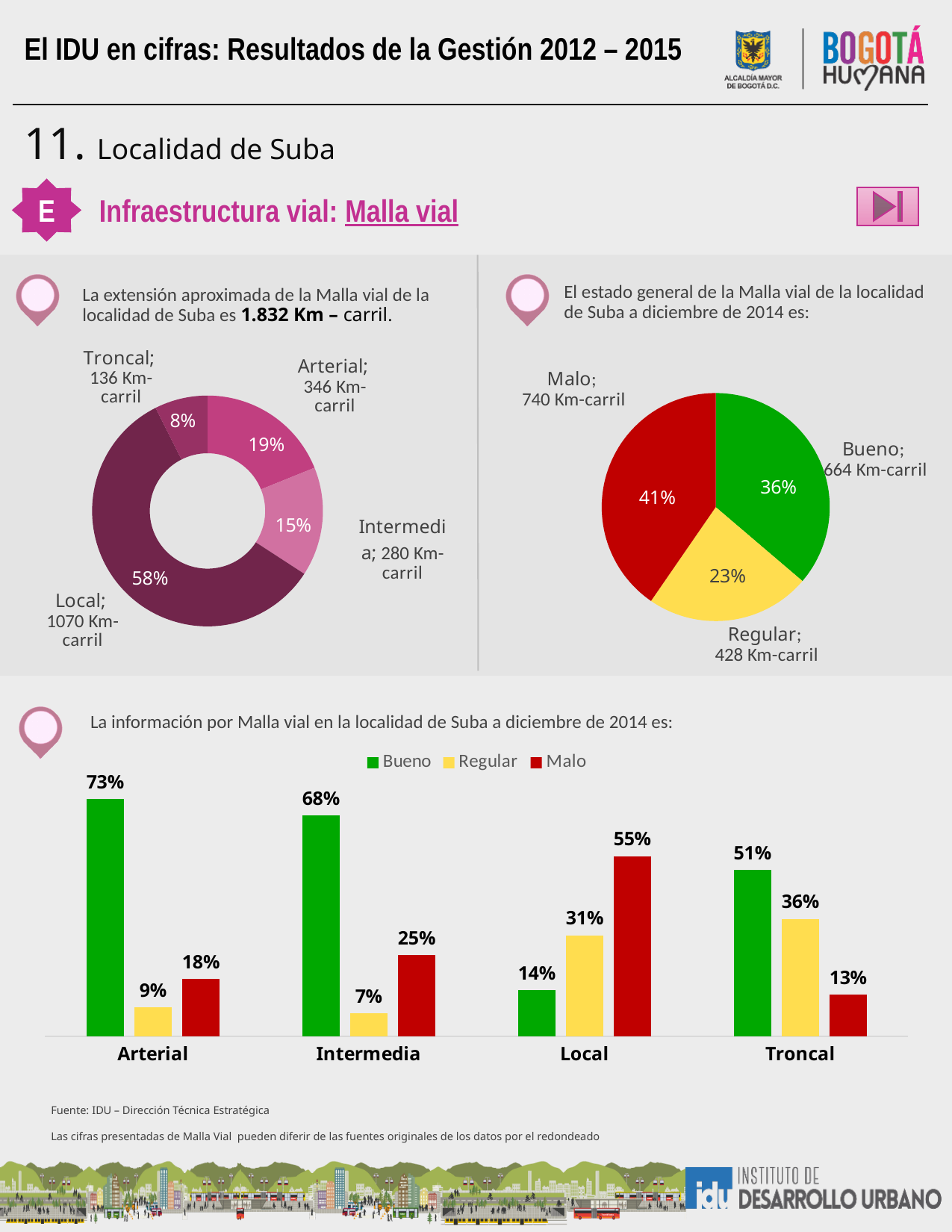
In the bottom bar chart, what is the difference between the Bueno values for Arterial and Troncal? 22% In the donut chart on the left, how many categories are shown? 4 In the pie chart on the right, what percentage share does Malo have? 41% In the donut chart on the left, what percentage share does Local have? 58% In the pie chart on the right, which state has the largest share? Malo In the bottom bar chart, what is the Malo value for Local? 55% In the donut chart on the left, which category has the smallest share? Troncal In the bottom bar chart, how many series does the legend list? 3 In the donut chart on the left, how many Km-carril does Arterial have? 346 Km-carril In the bottom bar chart, what is the Bueno value for Intermedia? 68% What kind of chart is the bottom chart? Bar chart In the pie chart on the right, how many Km-carril are in Regular state? 428 Km-carril